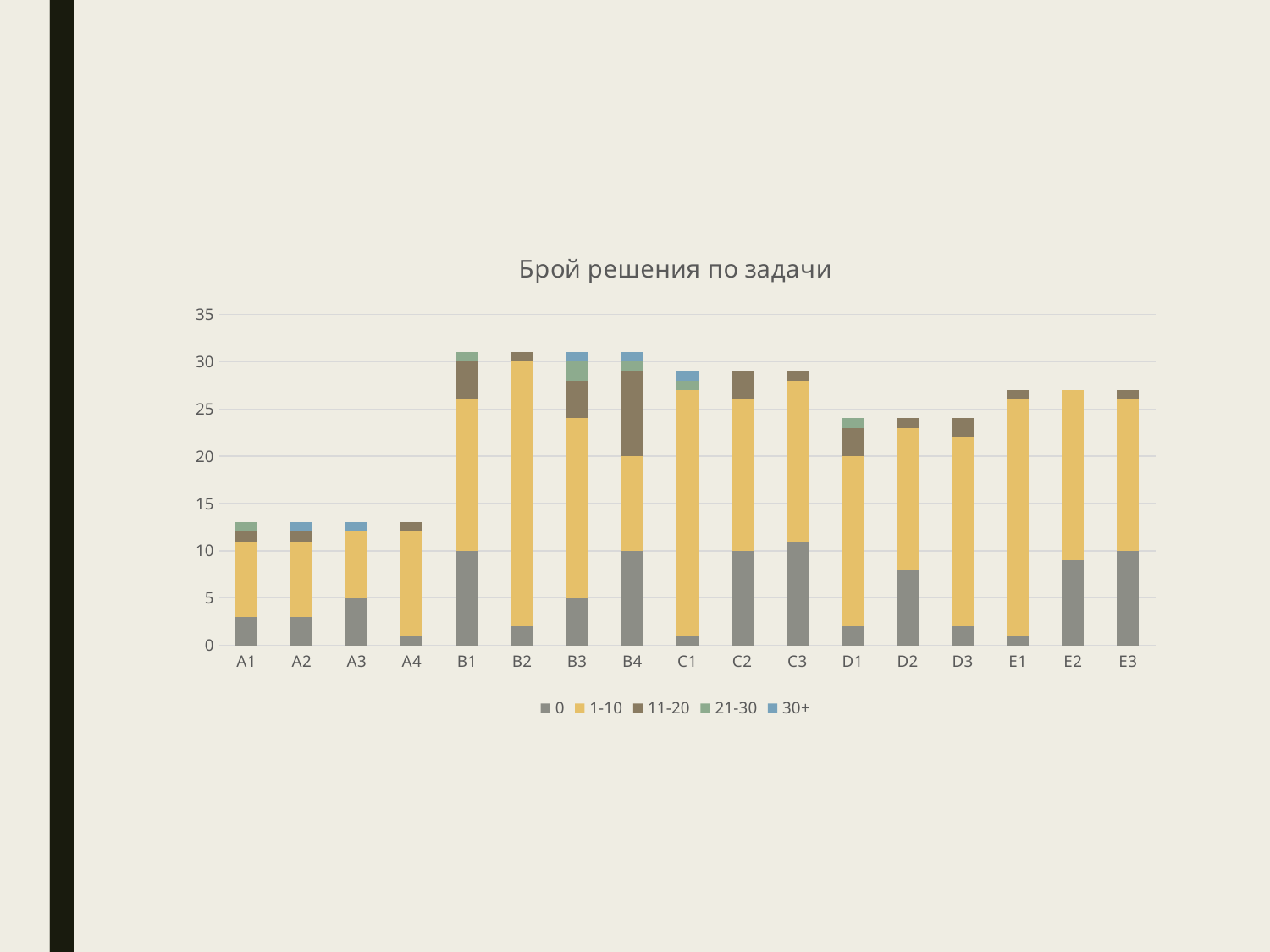
Is the total of the stacked bar for B2 greater or less than 25? greater Is the total of the stacked bar for A1 greater or less than 15? less Which series are listed in the legend? 0, 1-10, 11-20, 21-30, 30+ How many categories are shown on the x axis? 17 Which stacked bar is taller, D1 or E2? E2 Which has the larger value for the '0' series, C3 or A3? C3 What kind of chart is shown on the slide? stacked bar chart What is the title of the chart? Брой решения по задачи Is the total of the stacked bar for E2 greater or less than 25? greater Which stacked bar is taller, B2 or A2? B2 How many series does the legend list? 5